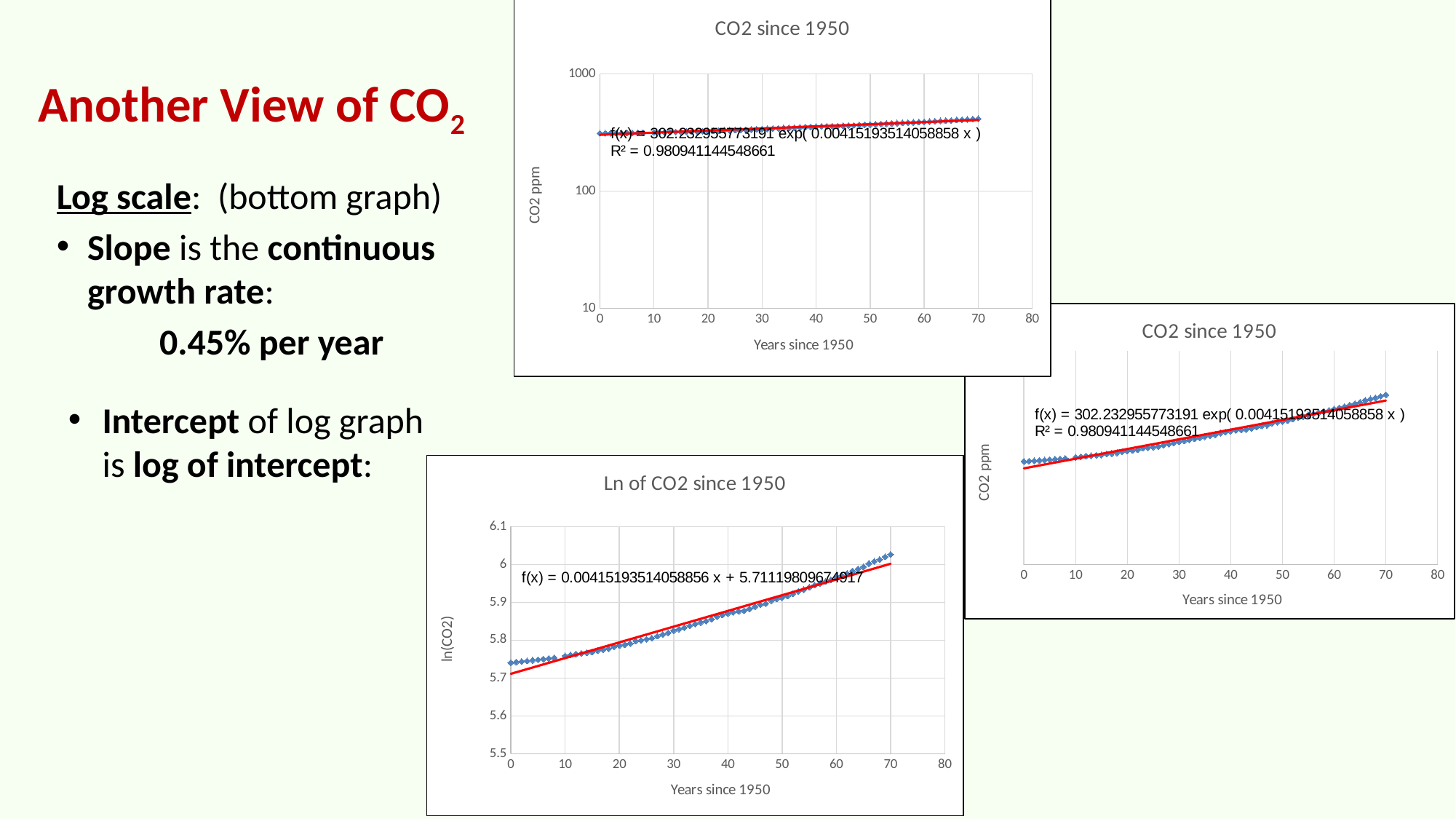
What kind of chart is the bottom chart titled 'Ln of CO2 since 1950'? scatter chart In the bottom chart 'Ln of CO2 since 1950', what is the trendline equation shown? f(x) = 0.00415193514058856 x + 5.71119809674917 In the top chart 'CO2 since 1950', is the CO2 ppm value at 0 years since 1950 greater or less than 1000? less In the top chart 'CO2 since 1950', what R² value is shown for the trendline? R² = 0.980941144548661 In the top chart 'CO2 since 1950', is the CO2 ppm value at 70 years since 1950 greater or less than 100? greater In the bottom chart 'Ln of CO2 since 1950', do the values rise or fall as years since 1950 increase? rise In the bottom chart 'Ln of CO2 since 1950', is the ln(CO2) value at 70 years since 1950 greater or less than 6? greater In the top chart 'CO2 since 1950', what is the trendline equation shown? f(x) = 302.232955773191 exp( 0.00415193514058858 x ) What is the title of the bottom chart? Ln of CO2 since 1950 In the right chart 'CO2 since 1950', do the CO2 values rise or fall as years since 1950 increase? rise What is the x-axis label of the right chart 'CO2 since 1950'? Years since 1950